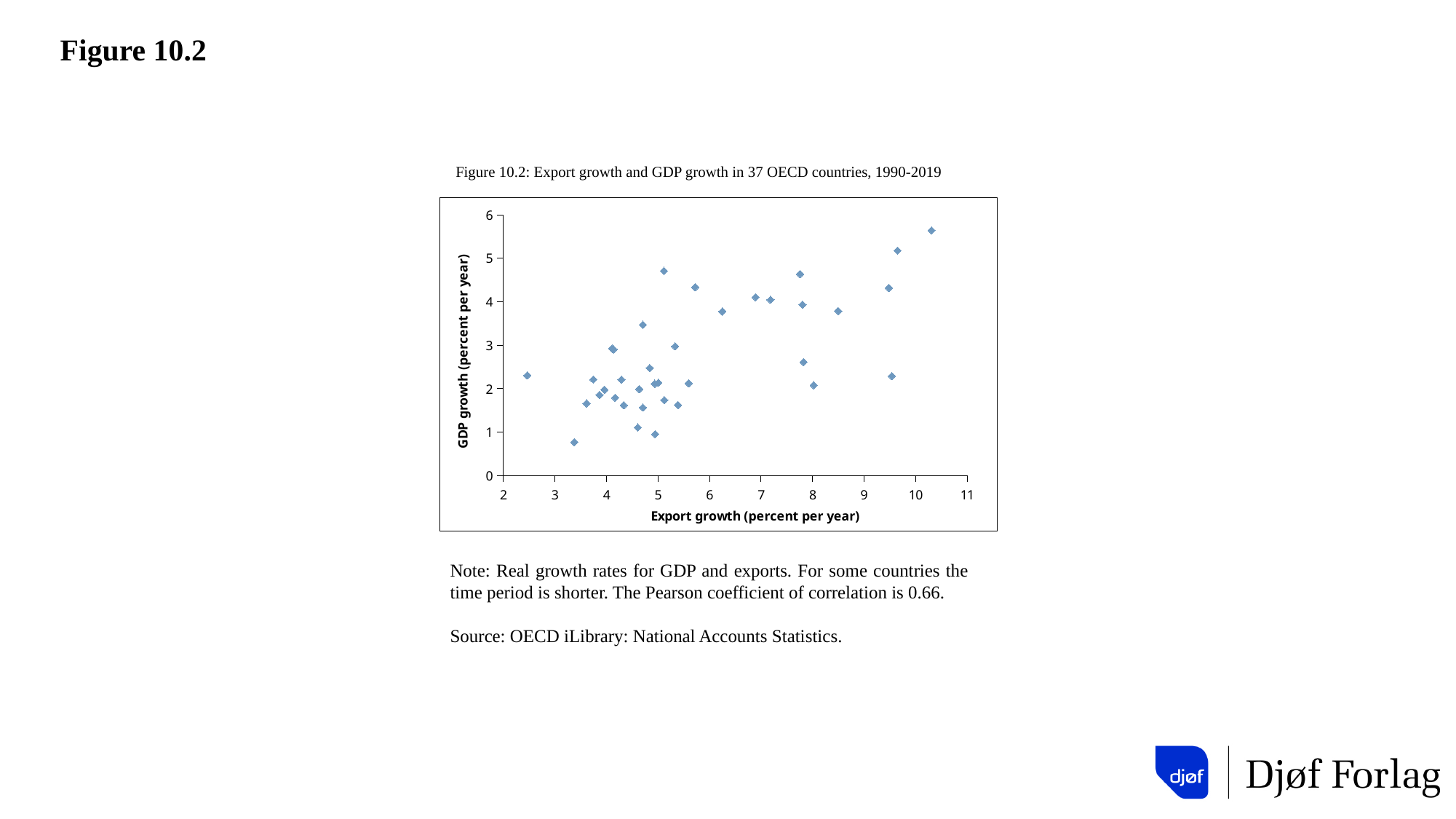
Is the export growth of the point furthest to the right greater or less than 10? greater Is the GDP growth of the lowest point in the chart greater or less than 1? less How many points have an export growth below 3 percent per year? 1 How many OECD countries are plotted in the chart, according to its title? 37 How many points have a GDP growth above 5 percent per year? 2 What is the title of the chart? Figure 10.2: Export growth and GDP growth in 37 OECD countries, 1990-2019 What is the highest value shown on the x axis? 11 As export growth increases along the x axis, does GDP growth tend to rise or fall? Rise What kind of chart is shown on the slide? Scatter plot What is the Pearson coefficient of correlation stated in the note below the chart? 0.66 Is the GDP growth of the point furthest to the left (export growth below 3) greater or less than 3? less